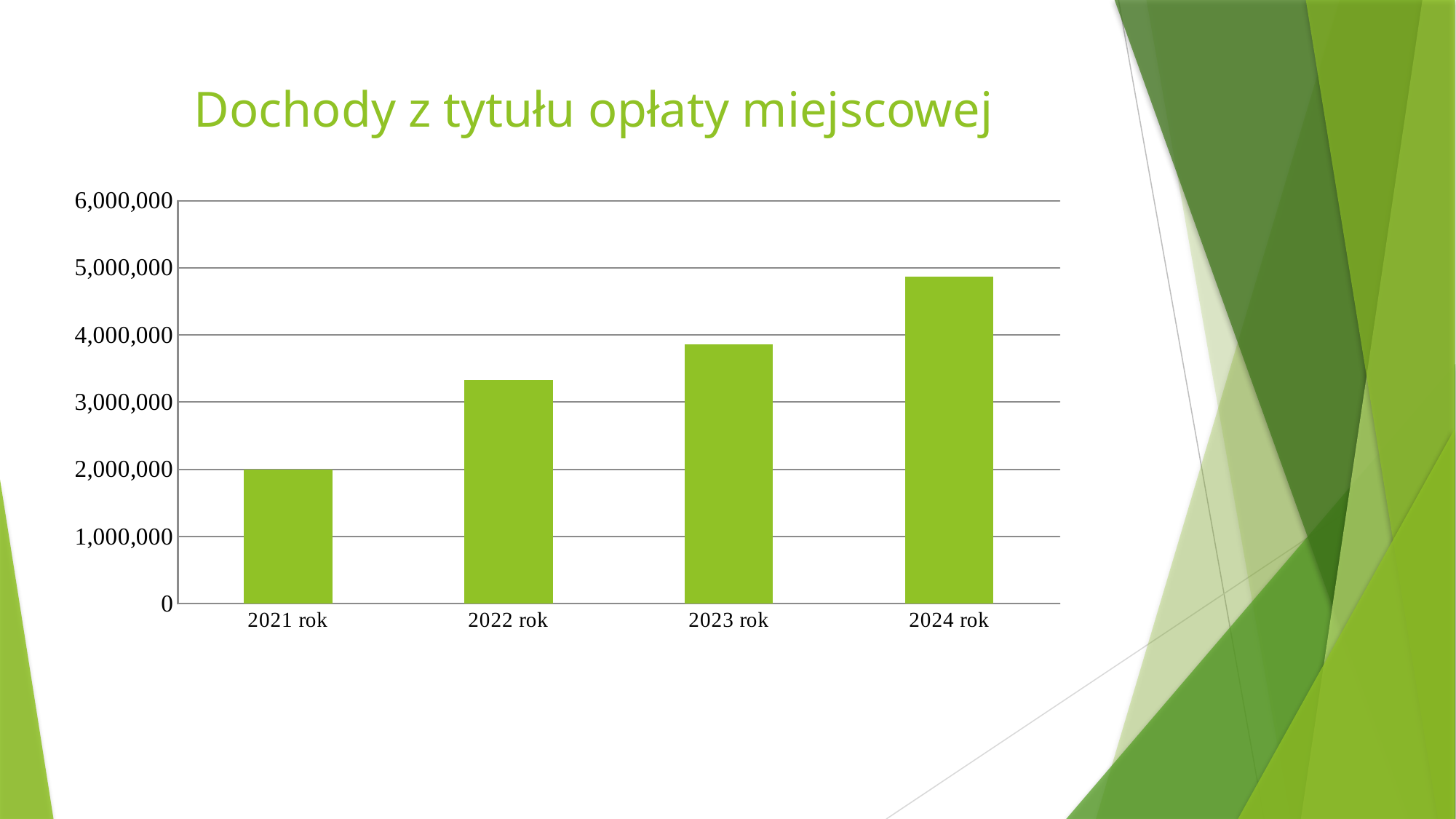
What colour are the bars in the chart? green What is the title of the chart on the slide? Dochody z tytułu opłaty miejscowej Is the value for 2023 rok greater or less than 4,000,000? less How many categories (years) are plotted on the chart? 4 Which year has the lowest value on the chart? 2021 rok Which is larger, the value for 2022 rok or the value for 2023 rok? 2023 rok Is the value for 2024 rok greater or less than 4,000,000? greater Is the value for 2021 rok greater or less than 3,000,000? less Do the values rise or fall from 2021 rok to 2024 rok? rise What kind of chart is shown on the slide? bar chart Which year has the highest value on the chart? 2024 rok